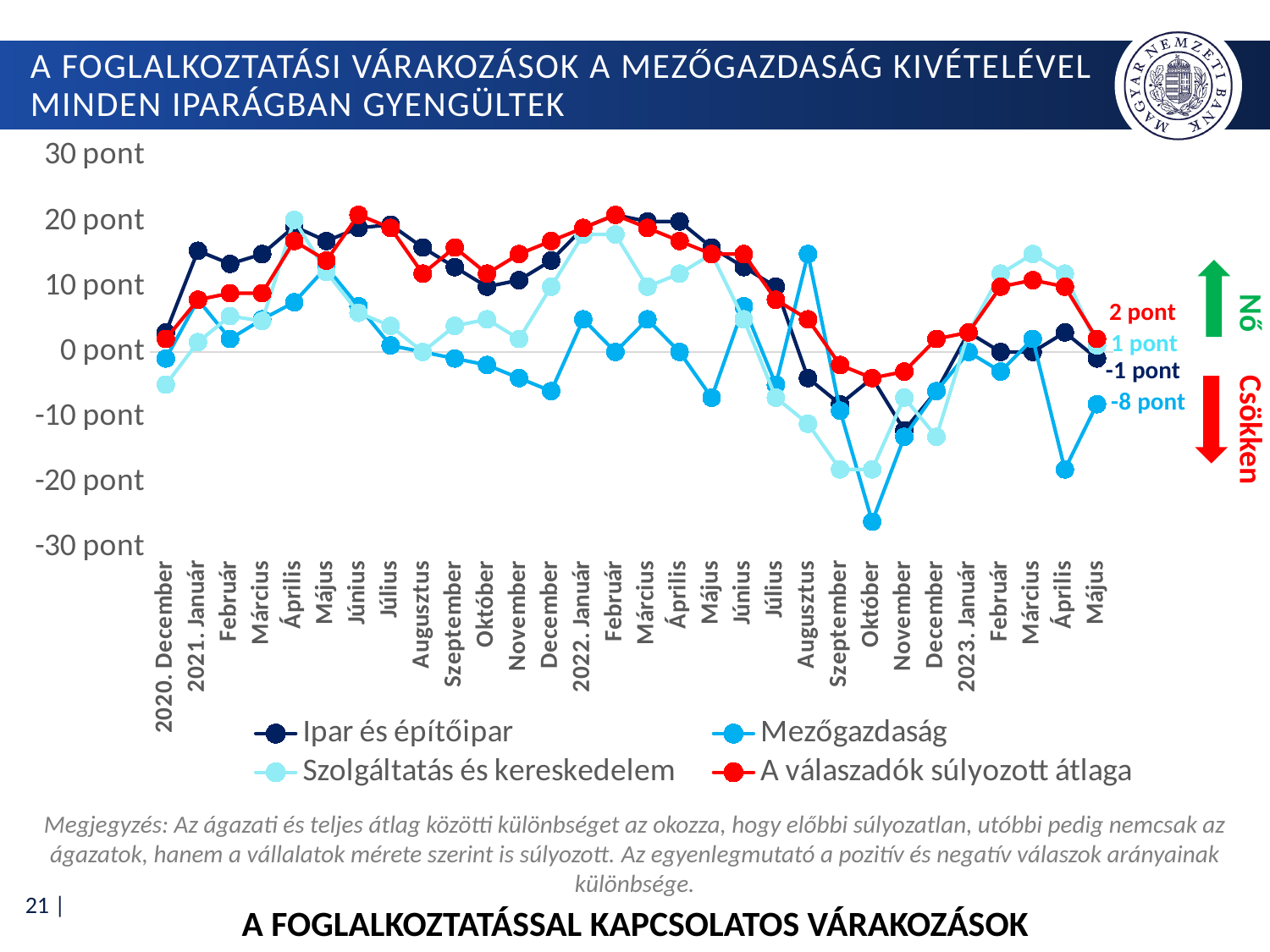
What is the title shown below the chart? A foglalkoztatással kapcsolatos várakozások What is the value of 'Mezőgazdaság' in 2023 Május? -8 pont What is the value of 'Szolgáltatás és kereskedelem' in 2023 Május? 1 pont Which series has the lowest value in 2023 Május? Mezőgazdaság What is the value of 'Ipar és építőipar' in 2023 Május? -1 pont Which series has the highest value in 2023 Május? A válaszadók súlyozott átlaga How many series does the legend list? 4 What is the difference between 'A válaszadók súlyozott átlaga' and 'Mezőgazdaság' in 2023 Május? 10 pont What is the value of 'A válaszadók súlyozott átlaga' in 2023 Május? 2 pont Is the value for 'Ipar és építőipar' in 2021 Január greater or less than 10 pont? greater Is the value for 'Mezőgazdaság' in 2022 Október greater or less than -20 pont? less What kind of chart is shown on the slide? line chart